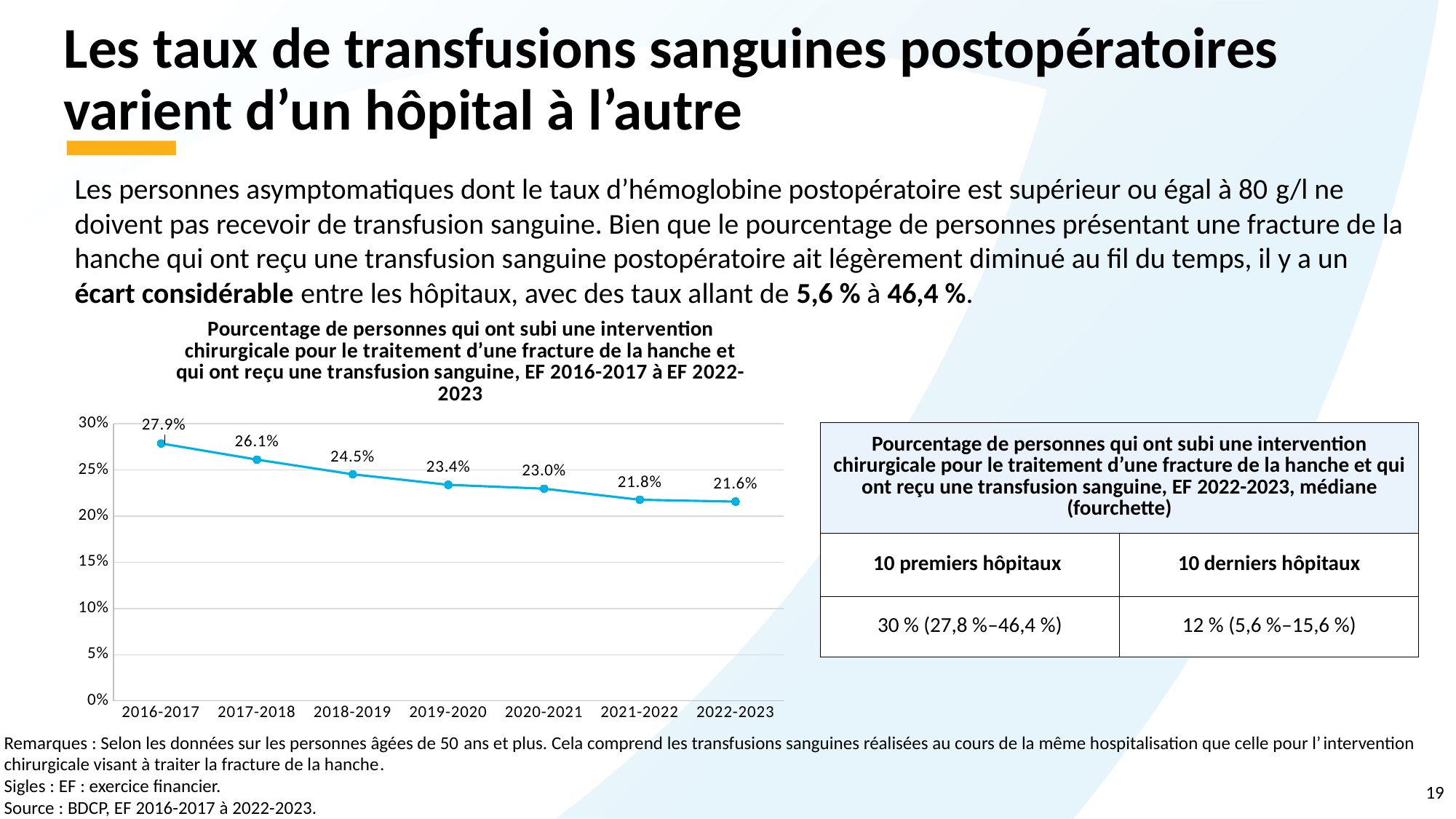
How many years are plotted on the x axis? 7 What kind of chart is shown? line chart What is the difference between the values for 2020-2021 and 2021-2022? 1.2% Do the values rise or fall from 2016-2017 to 2022-2023? fall What is the value for 2022-2023? 21.6% Which year has the lowest value? 2022-2023 What is the difference between the values for 2016-2017 and 2022-2023? 6.3% Which is larger, the value for 2017-2018 or the value for 2020-2021? 2017-2018 Which year has the highest value? 2016-2017 What is the value for 2019-2020? 23.4% What is the value for 2016-2017? 27.9% Is the value for 2018-2019 greater or less than 20%? greater